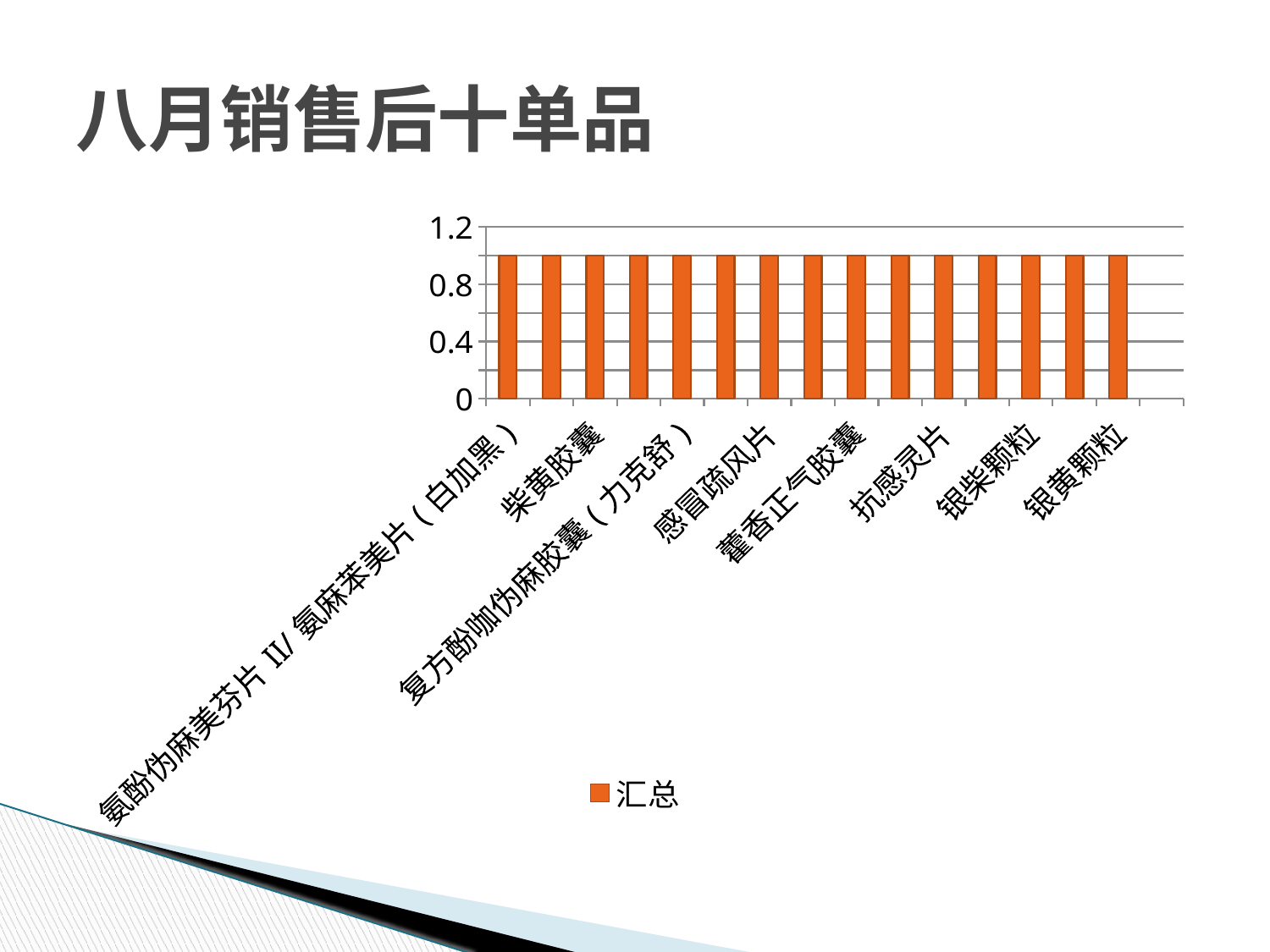
Is the value for 感冒疏风片 greater or less than 1.2? less Is the value for 抗感灵片 greater or less than 0.8? greater What kind of chart is shown on the slide? bar chart Is the value for 银黄颗粒 greater or less than 1.2? less What is the name of the series shown in the chart legend? 汇总 How many bars are plotted in the chart? 15 How many series does the chart legend list? 1 Do the bar values rise, fall, or stay the same from left to right along the x axis? stay the same What is the highest value labelled on the vertical axis? 1.2 What is the title of the slide containing the chart? 八月销售后十单品